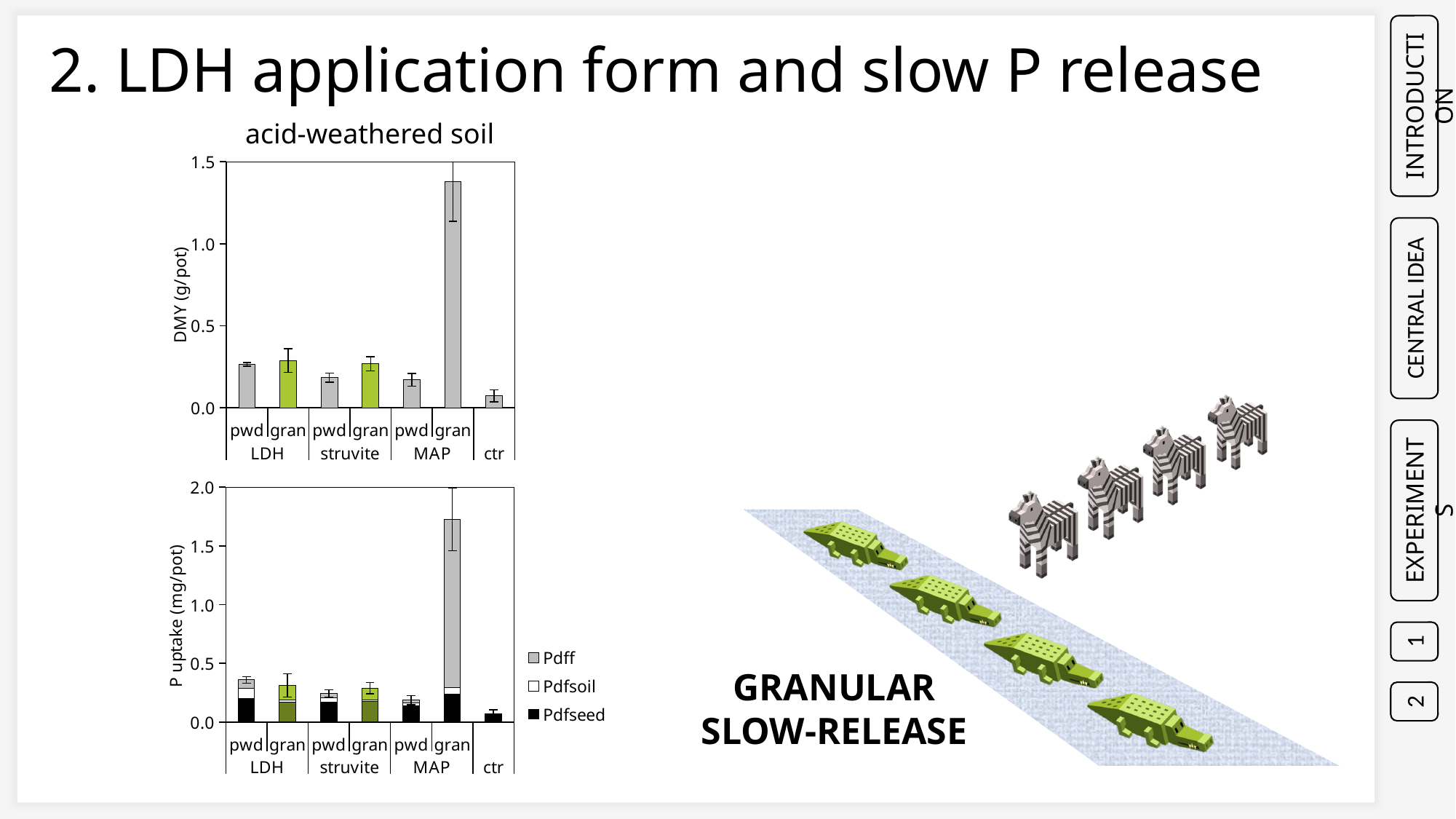
In the bottom chart (P uptake mg/pot), is the total for MAP gran greater or less than 1.5? greater In the top chart (DMY g/pot), is the value for MAP gran greater or less than 1.0? greater How many series does the legend of the bottom chart (P uptake) list? 3 In the bottom chart (P uptake mg/pot), which bar has the highest total? MAP gran In the top chart (DMY g/pot), which is larger: MAP gran or LDH pwd? MAP gran In the bottom chart (P uptake mg/pot), is the total for ctr greater or less than 0.5? less What is the title shown above the top chart? acid-weathered soil How many bars are plotted in the top chart (DMY g/pot)? 7 What type of chart is the bottom chart (P uptake mg/pot)? stacked bar chart In the top chart (DMY g/pot), which bar is the lowest? ctr In the top chart (acid-weathered soil, DMY), which bar is the highest? MAP gran